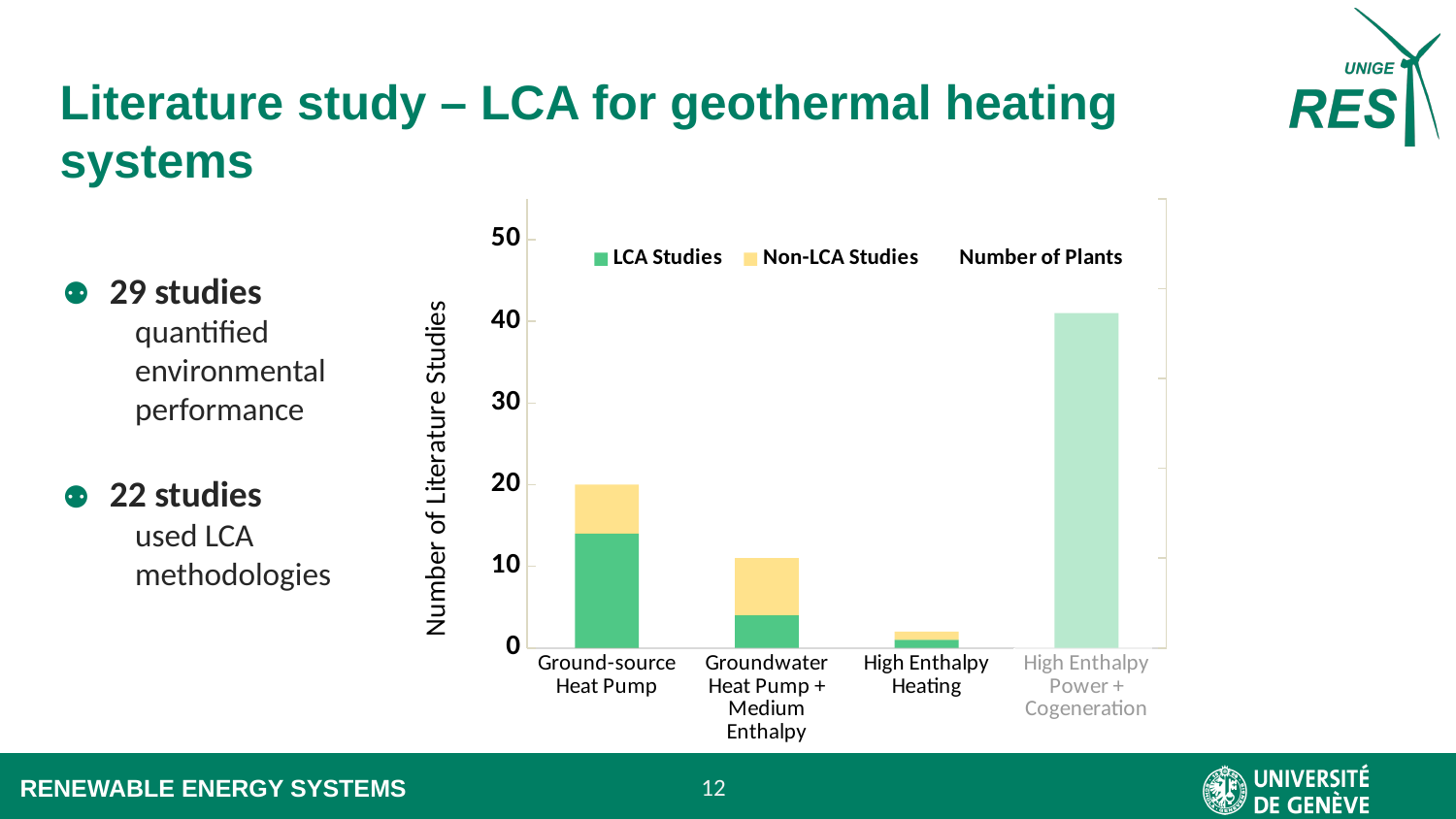
How many categories are shown on the x axis of the chart? 4 How many series does the chart legend list? 3 What kind of chart is shown on the slide? bar chart Is the value for High Enthalpy Power + Cogeneration greater or less than 40? greater Which category has the shortest bar in the chart? High Enthalpy Heating Which has the larger total bar: Ground-source Heat Pump or Groundwater Heat Pump + Medium Enthalpy? Ground-source Heat Pump What is the label of the y axis of the chart? Number of Literature Studies Is the LCA Studies value for Ground-source Heat Pump greater or less than 10? greater Is the total bar height for Groundwater Heat Pump + Medium Enthalpy greater or less than 20? less Which category has the tallest bar in the chart? High Enthalpy Power + Cogeneration Which legend entry is shown in yellow? Non-LCA Studies